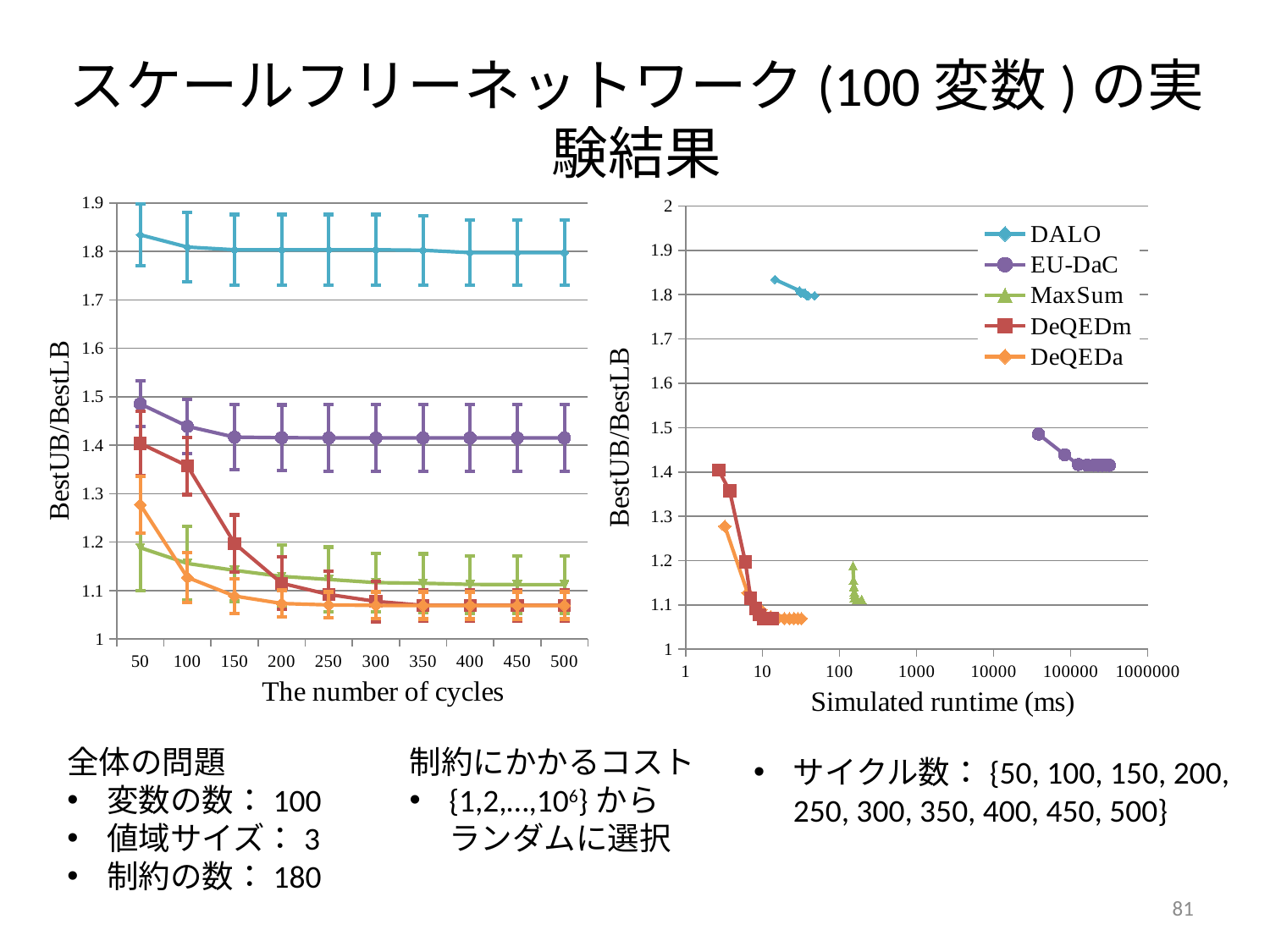
In the right chart, which series has the larger Simulated runtime, DALO or EU-DaC? EU-DaC How many series does the legend of the right chart (Simulated runtime) list? 5 In the right chart, are the MaxSum values greater or less than 1.3? less In the left chart, is the DALO value at 500 cycles greater or less than 1.7? greater In the left chart, do the DeQEDm values rise or fall as The number of cycles increases? fall What is the x-axis title of the right chart? Simulated runtime (ms) In the left chart, how many values of The number of cycles are shown on the x axis? 10 In the left chart at 50 cycles, which is larger, the DALO value or the EU-DaC value? DALO What kind of chart is the left chart, plotted against The number of cycles? line chart What is the y-axis title of the left chart? BestUB/BestLB In the left chart, is the EU-DaC value at 500 cycles greater or less than 1.5? less In the right chart (Simulated runtime), which series has the highest BestUB/BestLB values? DALO